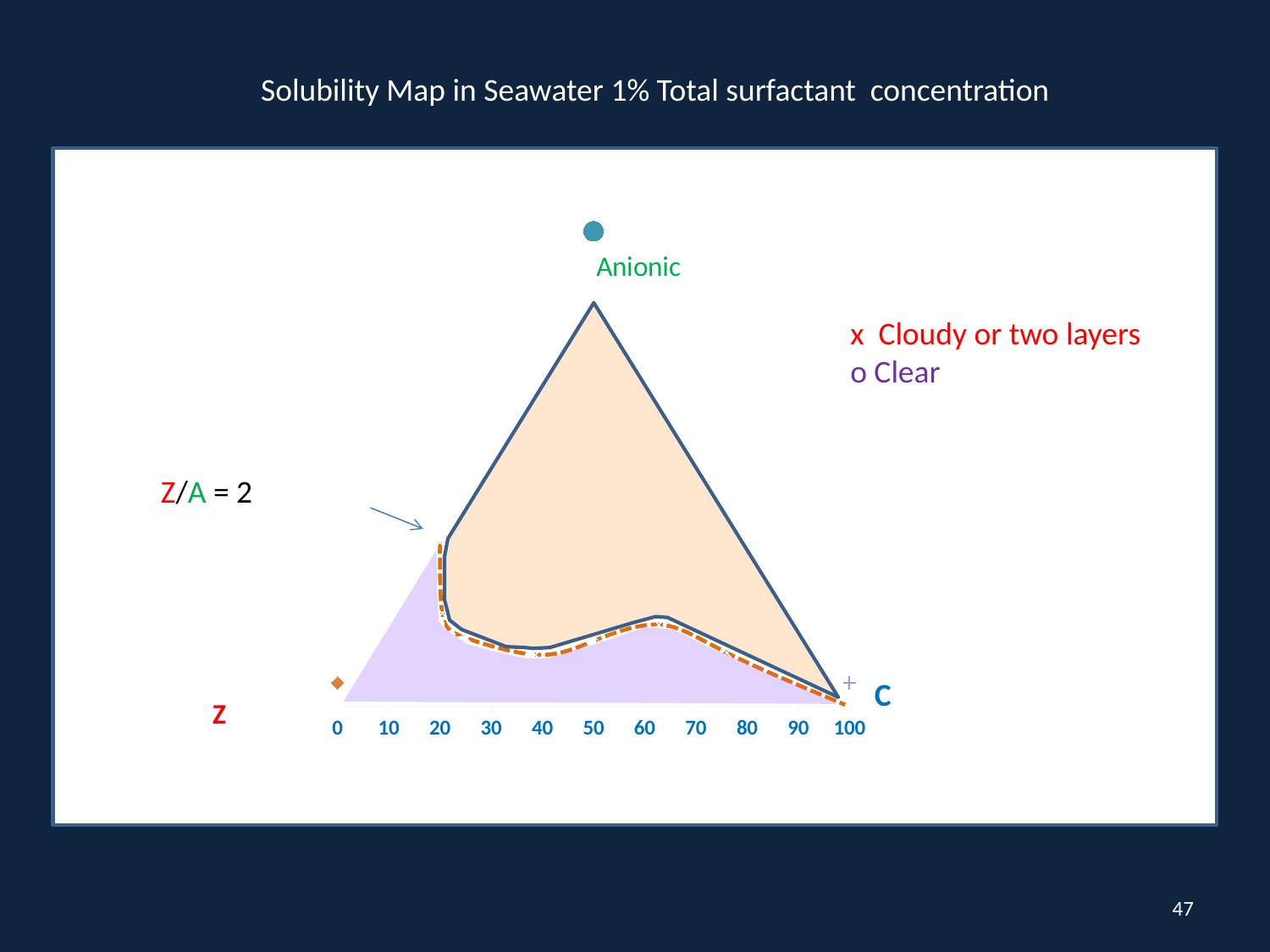
How many entries does the legend list? 2 What is the smallest tick value printed along the bottom axis? 0 What kind of chart is shown on the slide? ternary (triangular) diagram What is the title of the chart on the slide? Solubility Map in Seawater 1% Total surfactant concentration What is the largest tick value printed along the bottom axis? 100 According to the legend, what does the symbol x represent? Cloudy or two layers How many tick labels are printed along the bottom axis of the triangle? 11